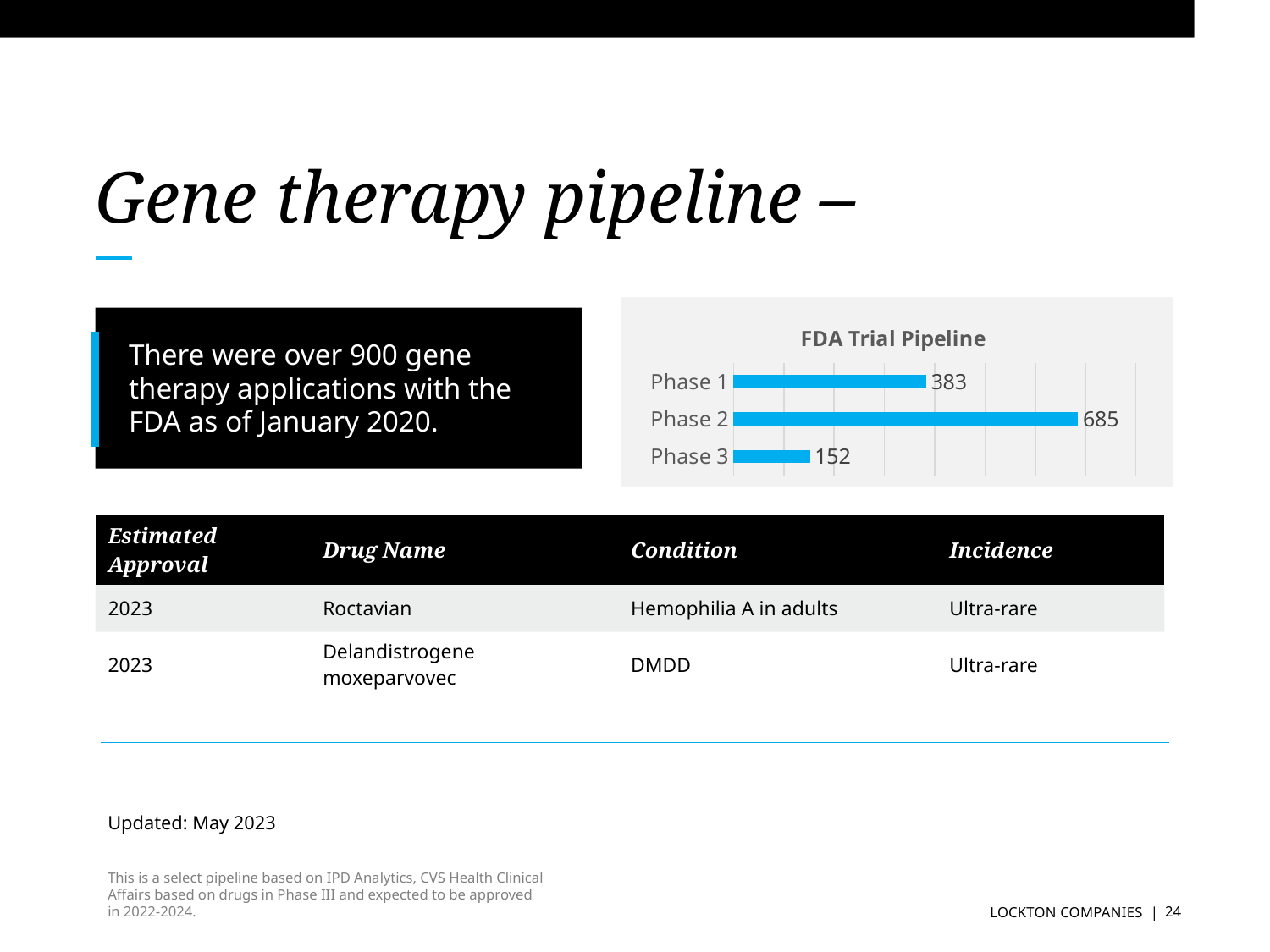
What kind of chart is the FDA Trial Pipeline chart? Bar chart Which is larger in the FDA Trial Pipeline chart, Phase 1 or Phase 3? Phase 1 What is the difference between the Phase 1 and Phase 3 values in the FDA Trial Pipeline chart? 231 Which phase has the highest value in the FDA Trial Pipeline chart? Phase 2 Which phase has the lowest value in the FDA Trial Pipeline chart? Phase 3 What is the value for Phase 2 in the FDA Trial Pipeline chart? 685 What is the difference between the Phase 2 and Phase 1 values in the FDA Trial Pipeline chart? 302 What is the value for Phase 1 in the FDA Trial Pipeline chart? 383 What is the value for Phase 3 in the FDA Trial Pipeline chart? 152 What is the title of the chart on the slide? FDA Trial Pipeline How many phases are shown in the FDA Trial Pipeline chart? 3 What is the total of the three phase values in the FDA Trial Pipeline chart? 1220